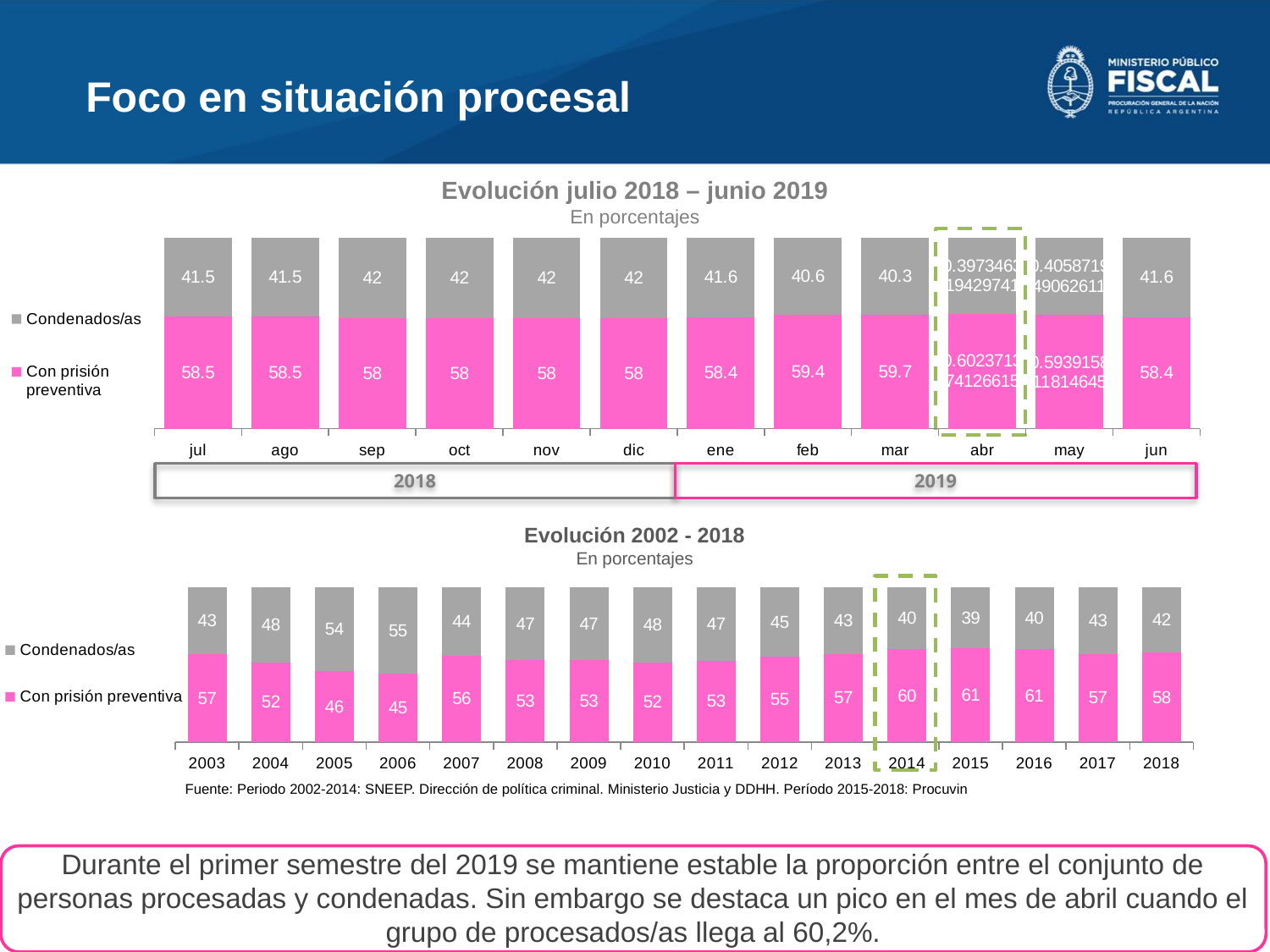
In the chart 'Evolución 2002 - 2018', what is the difference between the Condenados/as values in 2006 and 2015? 16 In the chart 'Evolución 2002 - 2018', what is the total of the stacked bar for 2018? 100 In the chart 'Evolución julio 2018 – junio 2019', what is the value for Condenados/as in feb? 40.6 In the chart 'Evolución julio 2018 – junio 2019', what is the difference between the Con prisión preventiva value in mar and in jul? 1.2 In the chart 'Evolución 2002 - 2018', what is the value for Condenados/as in 2014? 40 In the chart 'Evolución 2002 - 2018', which year has the lowest value for Con prisión preventiva? 2006 In the chart 'Evolución 2002 - 2018', which is larger: Con prisión preventiva in 2006 or in 2013? 2013 In the chart 'Evolución 2002 - 2018', which year has the highest value for Con prisión preventiva? 2015 and 2016 In the chart 'Evolución 2002 - 2018', how many years are shown on the x axis? 16 In the chart 'Evolución julio 2018 – junio 2019', what kind of chart is shown? Stacked bar chart In the chart 'Evolución julio 2018 – junio 2019', how many series does the legend list? 2 In the chart 'Evolución julio 2018 – junio 2019', what is the value for Con prisión preventiva in mar? 59.7